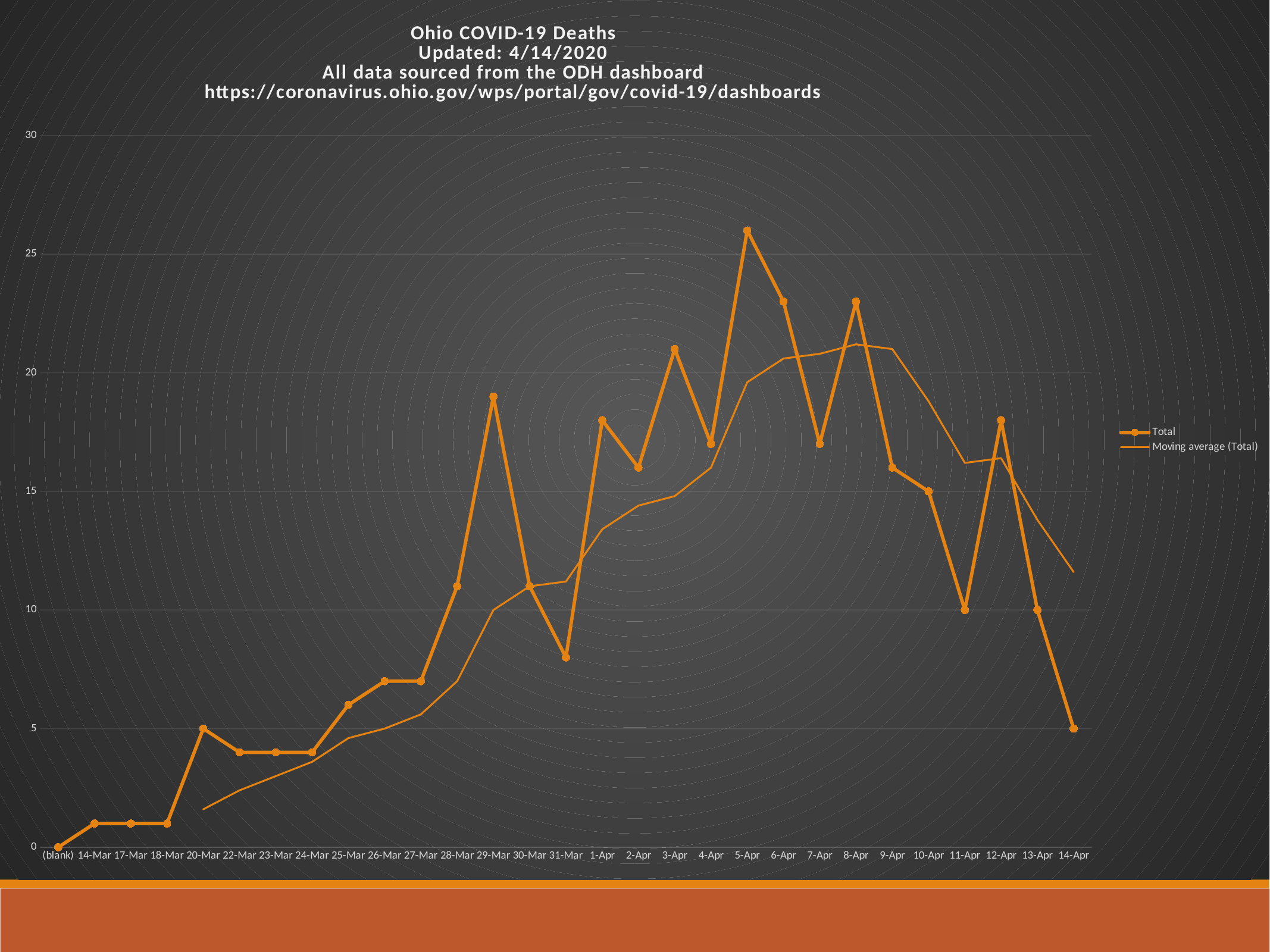
What kind of chart is shown on the slide? Line chart How many dates (categories) are shown along the x axis? 29 Which has the larger Total value, 5-Apr or 6-Apr? 5-Apr Is the Total value for 31-Mar greater or less than 10? less What are the two series named in the legend? Total and Moving average (Total) What is the Total value for 20-Mar? 5 Is the Total value for 29-Mar greater or less than 15? greater On which date does the Total series reach its highest value? 5-Apr How many series does the legend list? 2 What is the Total value for 11-Apr? 10 What is the difference between the Total values for 10-Apr and 11-Apr? 5 What is the Total value for 14-Apr? 5